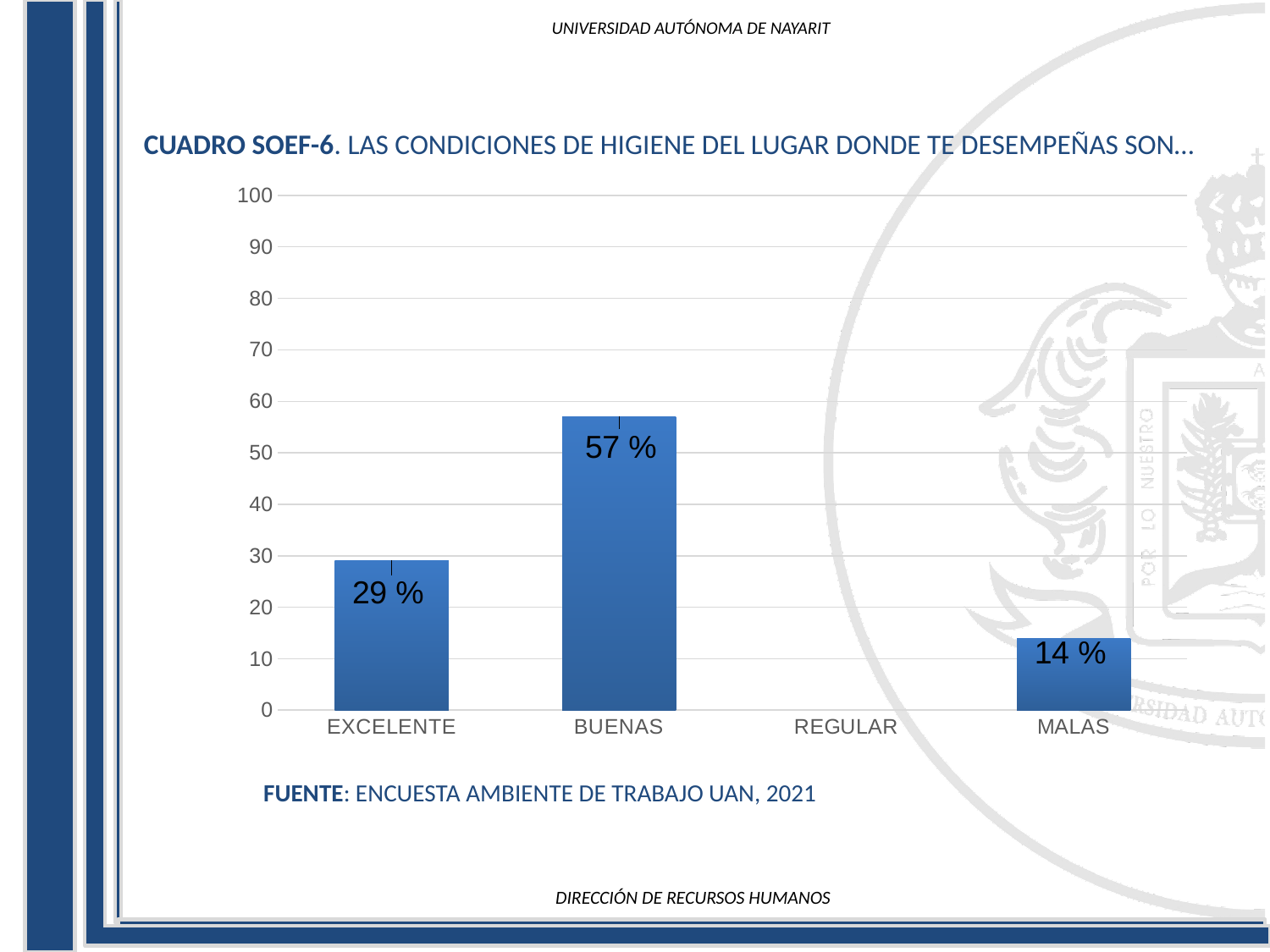
Which is larger, the value for EXCELENTE or the value for MALAS? EXCELENTE Is the value for BUENAS greater or less than 50? greater What is the value shown for BUENAS? 57 % Which category has the highest value? BUENAS What is the value shown for MALAS? 14 % What is the value shown for EXCELENTE? 29 % What kind of chart is shown on the slide? bar chart What is the difference between the values for BUENAS and EXCELENTE? 28 % What is the difference between the values for EXCELENTE and MALAS? 15 % Which category has the shortest visible bar? MALAS How many categories are shown on the x axis? 4 What source is cited below the chart? ENCUESTA AMBIENTE DE TRABAJO UAN, 2021